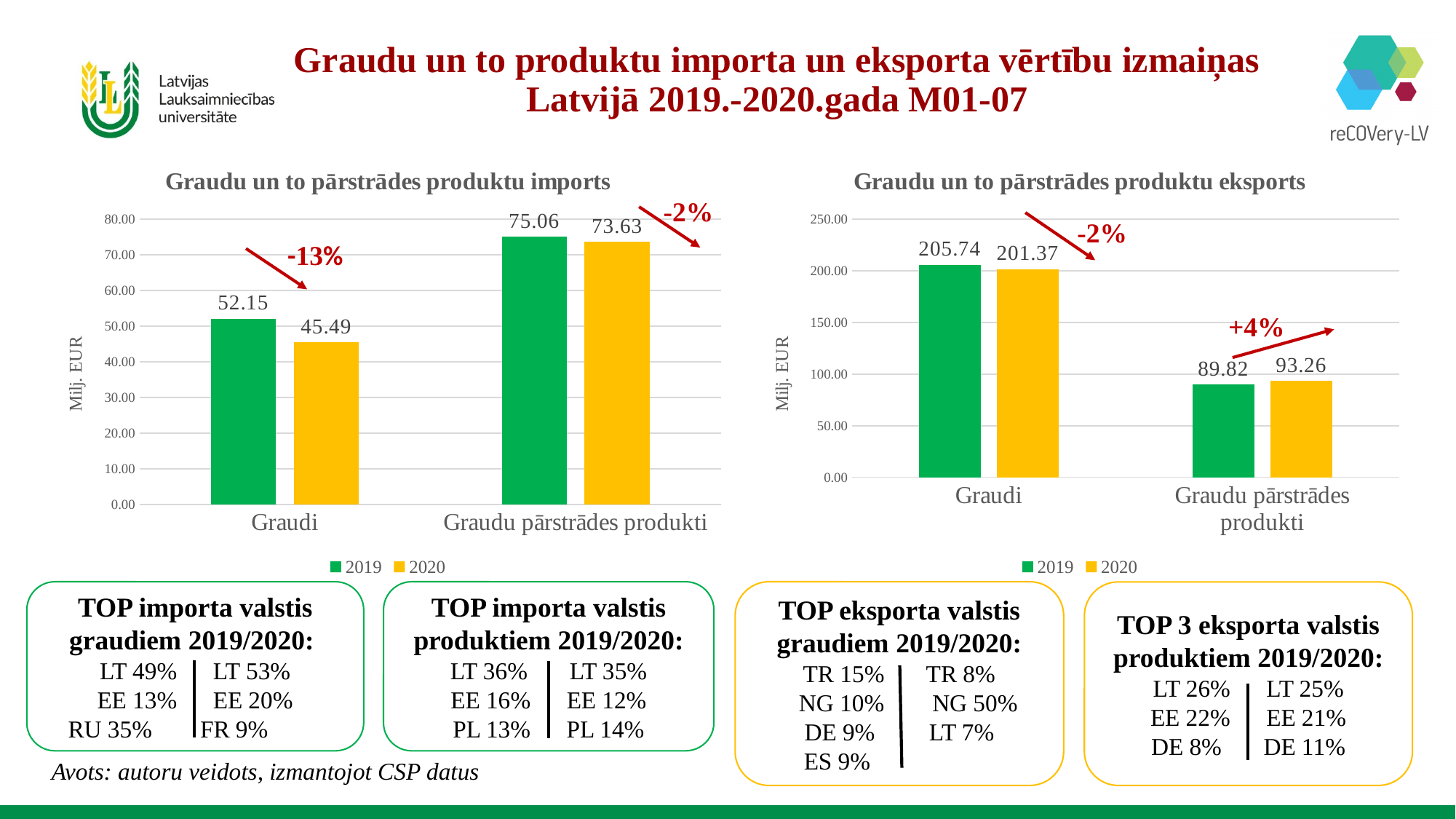
In the chart titled "Graudu un to pārstrādes produktu imports", what is the value for Graudu pārstrādes produkti in 2020? 73.63 In the chart titled "Graudu un to pārstrādes produktu eksports", which category has the highest value in 2019? Graudi In the chart titled "Graudu un to pārstrādes produktu eksports", what is the difference between the 2020 and 2019 values for Graudu pārstrādes produkti? 3.44 In the chart titled "Graudu un to pārstrādes produktu imports", what is the value for Graudi in 2019? 52.15 In the chart titled "Graudu un to pārstrādes produktu eksports", what is the value for Graudi in 2020? 201.37 What percentage change is annotated above the Graudi bars in the chart titled "Graudu un to pārstrādes produktu imports"? -13% What kind of chart is the chart titled "Graudu un to pārstrādes produktu eksports"? bar chart In the chart titled "Graudu un to pārstrādes produktu eksports", is the 2020 value for Graudu pārstrādes produkti larger or smaller than its 2019 value? larger In the chart titled "Graudu un to pārstrādes produktu imports", by how much did the value for Graudi fall from 2019 to 2020? 6.66 How many series does the legend of the chart titled "Graudu un to pārstrādes produktu imports" list? 2 In the chart titled "Graudu un to pārstrādes produktu imports", which category has the lowest value in 2020? Graudi In the chart titled "Graudu un to pārstrādes produktu eksports", what is the value for Graudu pārstrādes produkti in 2019? 89.82